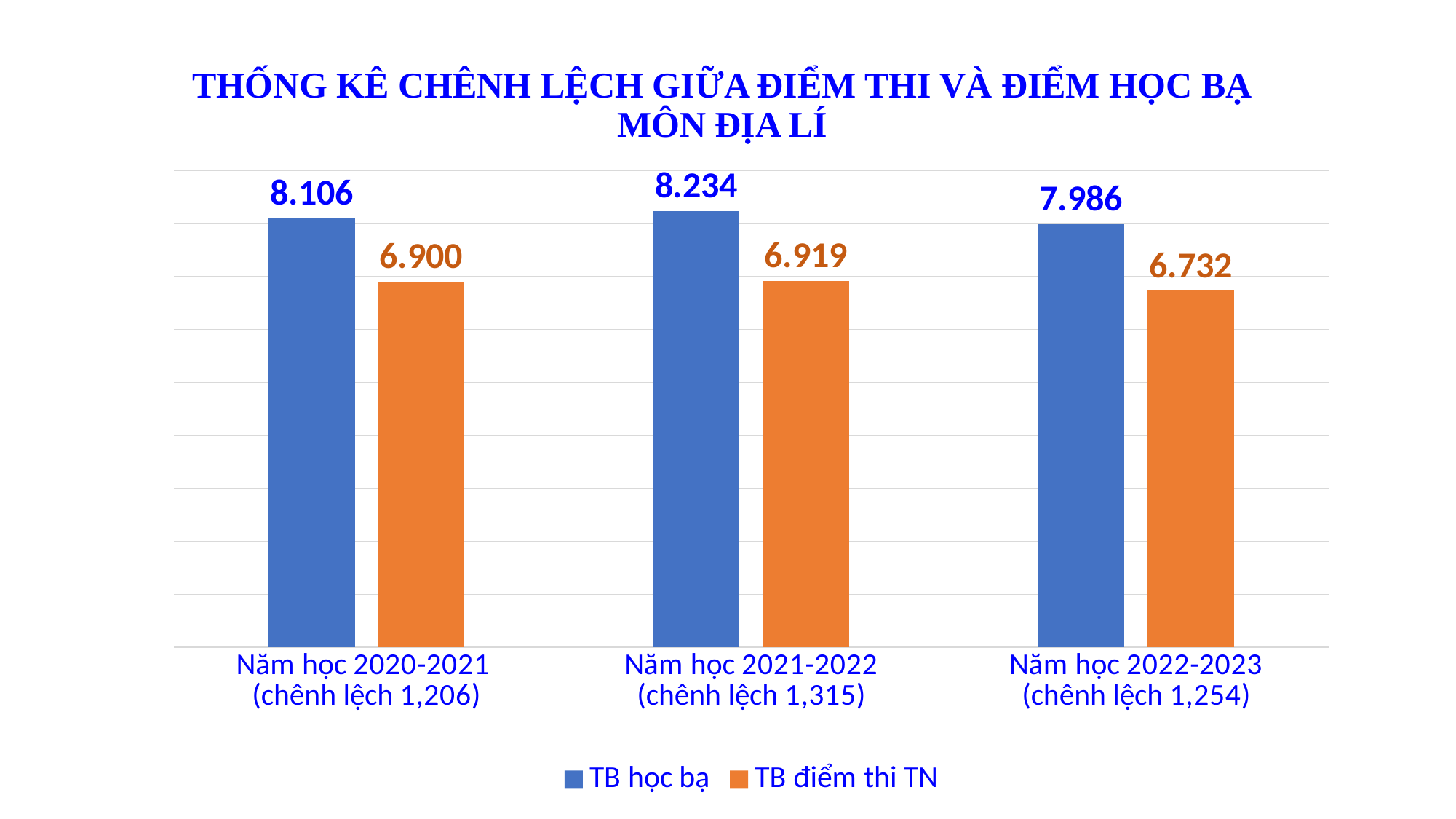
How many series does the legend list? 2 Which colour represents TB điểm thi TN in the chart? Orange What is the value of TB điểm thi TN for Năm học 2022-2023? 6.732 What is the value of TB học bạ for Năm học 2020-2021? 8.106 How many school years are shown on the x axis? 3 What is the difference between TB học bạ and TB điểm thi TN for Năm học 2020-2021? 1.206 What is the value of TB điểm thi TN for Năm học 2021-2022? 6.919 What kind of chart is shown on the slide? Bar chart Which is larger for Năm học 2021-2022: TB học bạ or TB điểm thi TN? TB học bạ What is the value of TB học bạ for Năm học 2022-2023? 7.986 Which school year has the highest TB học bạ value? Năm học 2021-2022 Which school year has the lowest TB điểm thi TN value? Năm học 2022-2023